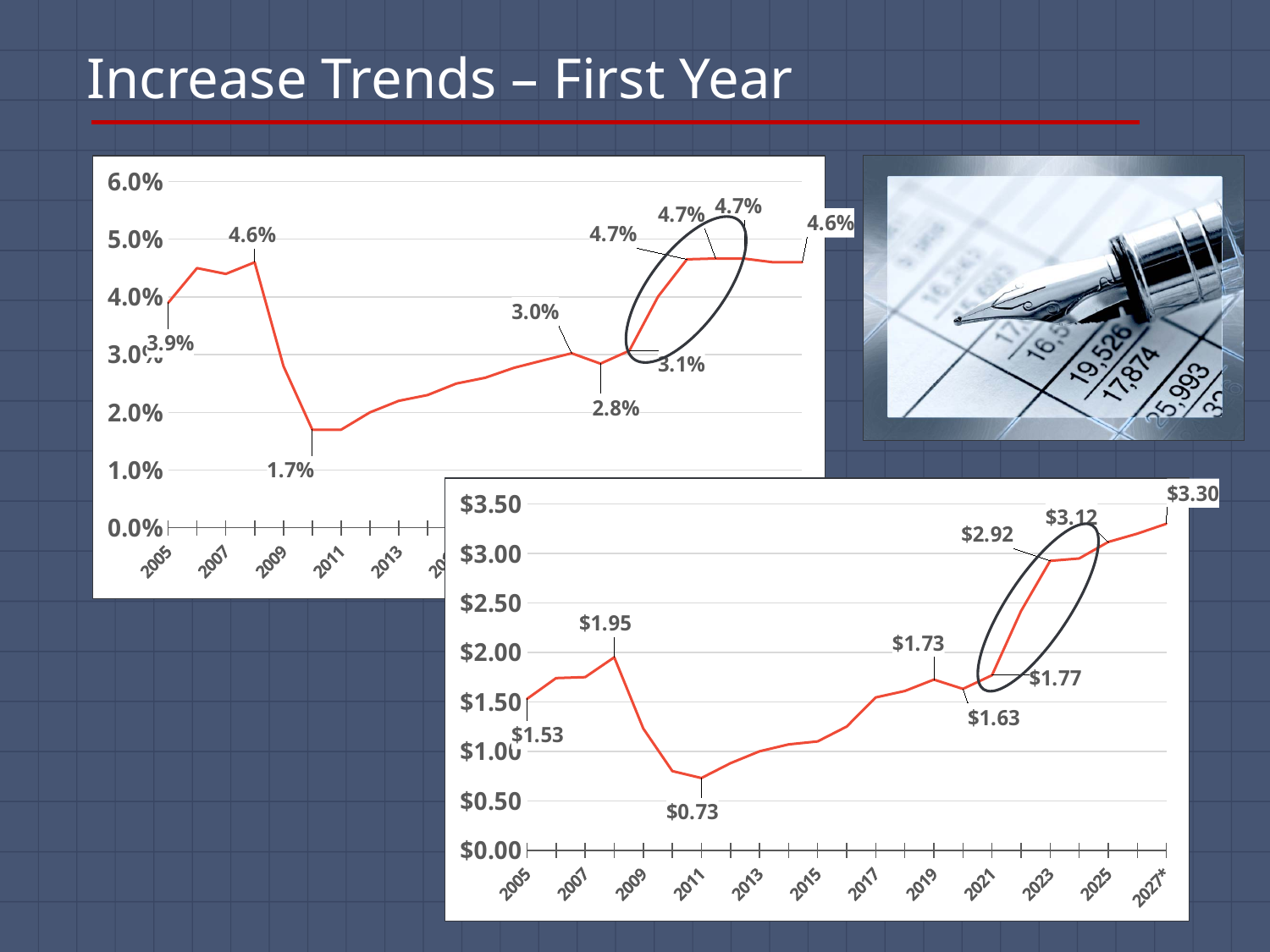
What kind of chart is the bottom-right chart on the slide? Line chart In the top-left chart, what is the value for 2005? 3.9% In the bottom-right chart, what is the difference between the 2027* value and the 2005 value? $1.77 In the bottom-right chart, is the value for 2015 greater or less than $1.50? less In the bottom-right chart, what is the value for 2005? $1.53 In the top-left chart, what is the difference between the 4.6% peak and the 1.7% low? 2.9 percentage points What colour is the data line in both charts? Red In the top-left chart, is the value for 2013 greater or less than 3.0%? less In the top-left chart, what is the lowest labelled value? 1.7% In the bottom-right chart, which year has the lowest value? 2011 In the bottom-right chart, which is larger, the value for 2019 or the value for 2020? 2019 In the bottom-right chart, what is the value for 2027*? $3.30